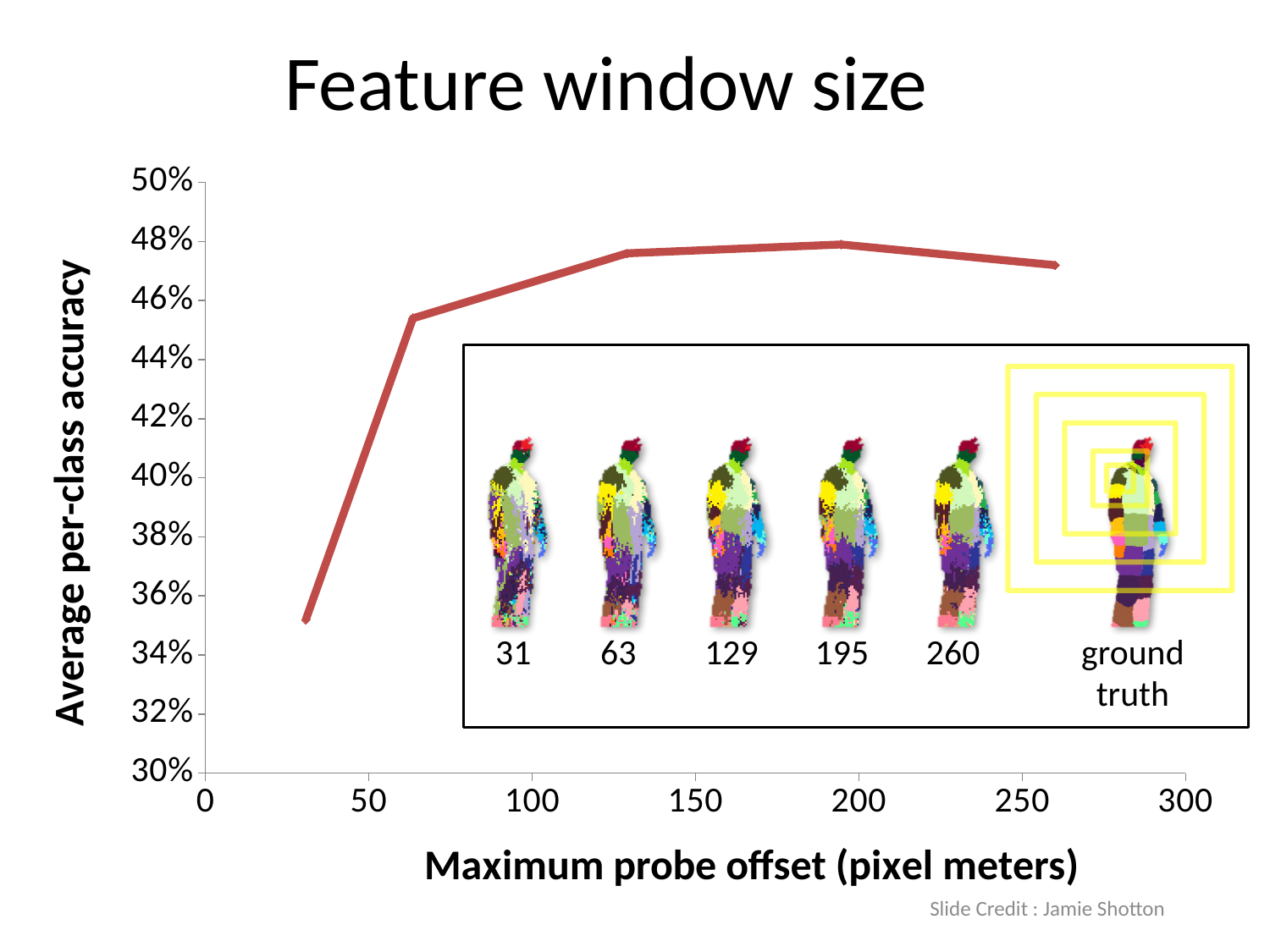
Is the average per-class accuracy at a maximum probe offset of 63 greater or less than 44%? greater At which maximum probe offset is the average per-class accuracy lowest? 31 Is the average per-class accuracy at a maximum probe offset of 260 greater or less than 46%? greater What kind of chart is shown on the slide? line chart Is the average per-class accuracy at a maximum probe offset of 31 greater or less than 36%? less What is the title of the slide's chart? Feature window size What is the label of the x axis? Maximum probe offset (pixel meters) How many data points are plotted on the line? 5 Which has the higher average per-class accuracy: a maximum probe offset of 31 or 63? 63 Which has the higher average per-class accuracy: a maximum probe offset of 63 or 129? 129 Does the average per-class accuracy rise or fall as the maximum probe offset increases from 31 to 129? rise